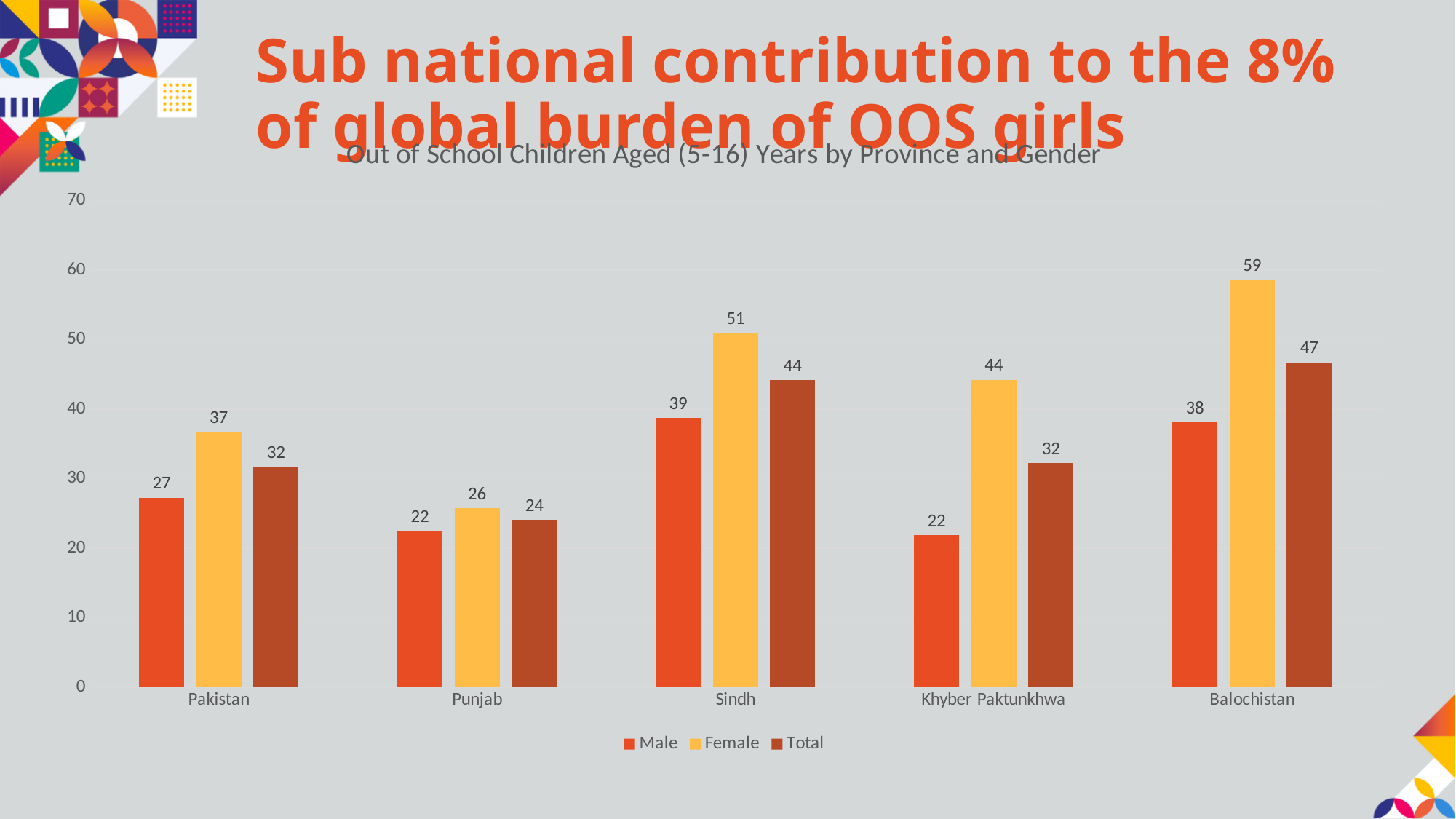
What is the difference between the Female and Male values for Khyber Paktunkhwa? 22 Which province has the highest Female value? Balochistan What is the title of the chart? Out of School Children Aged (5-16) Years by Province and Gender How many series does the legend list? 3 Which province has the lowest Total value? Punjab What is the Male value for Balochistan? 38 How many provinces/categories are shown on the x axis? 5 Is the Female value for Balochistan greater or less than 50? greater What is the Total value for Khyber Paktunkhwa? 32 What kind of chart is shown on the slide? Bar chart Which is larger, the Total value for Sindh or the Total value for Pakistan? Sindh What is the Female value for Sindh? 51